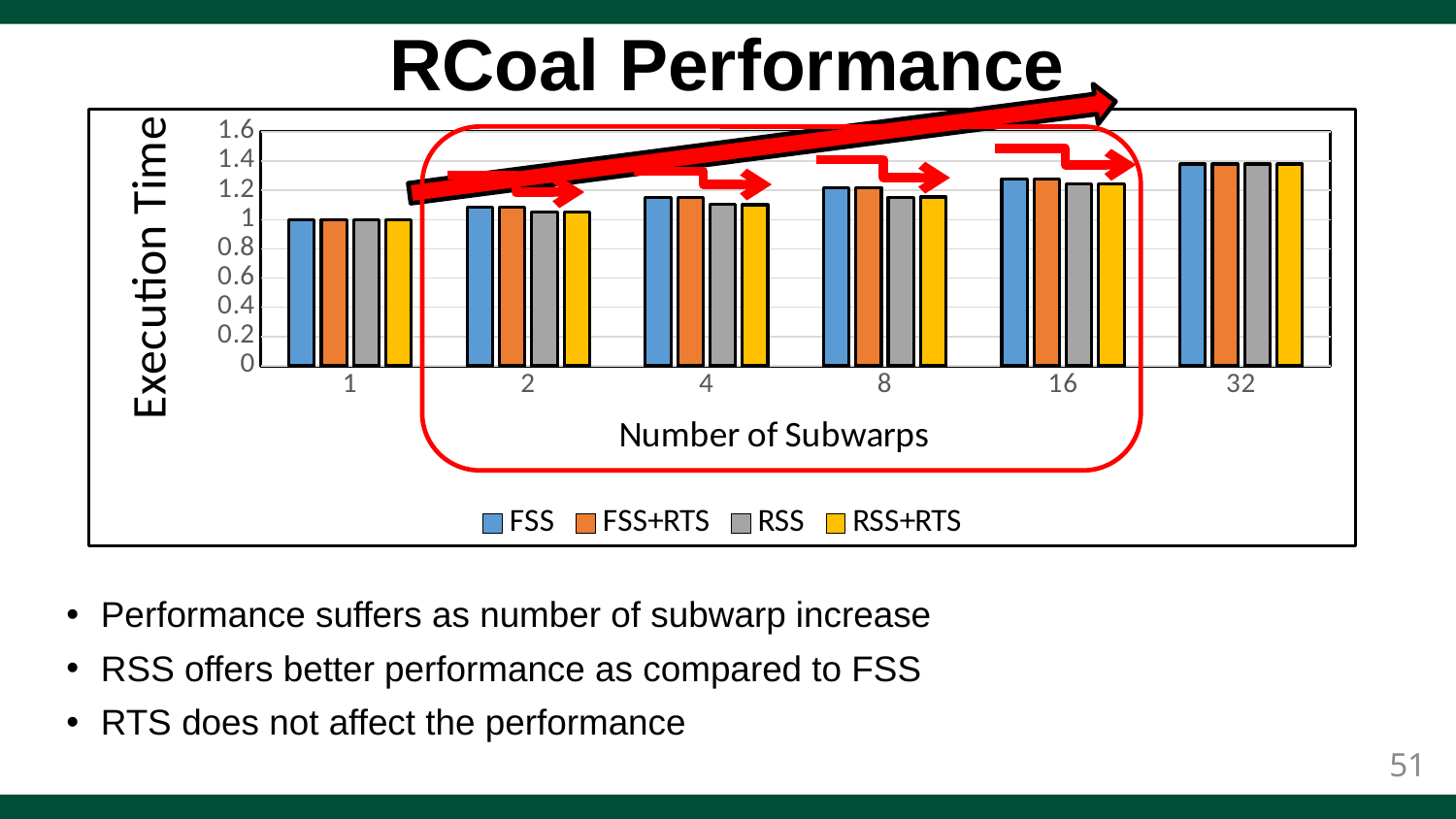
Is the execution time for FSS at 32 subwarps greater or less than 1.2? greater How many categories are shown on the x axis (Number of Subwarps)? 6 Do the execution time values rise or fall as the number of subwarps increases? rise Is the execution time for FSS+RTS at 2 subwarps greater or less than 1? greater How many series does the legend list? 4 Which number of subwarps has the highest execution time for FSS? 32 Which is larger: the execution time for FSS at 32 subwarps or at 2 subwarps? 32 subwarps What kind of chart is shown on the slide? bar chart Is the execution time for RSS at 4 subwarps greater or less than 1.2? less Which number of subwarps has the lowest execution time for RSS? 1 What is the label of the y axis? Execution Time What is the execution time for FSS at 1 subwarp? 1